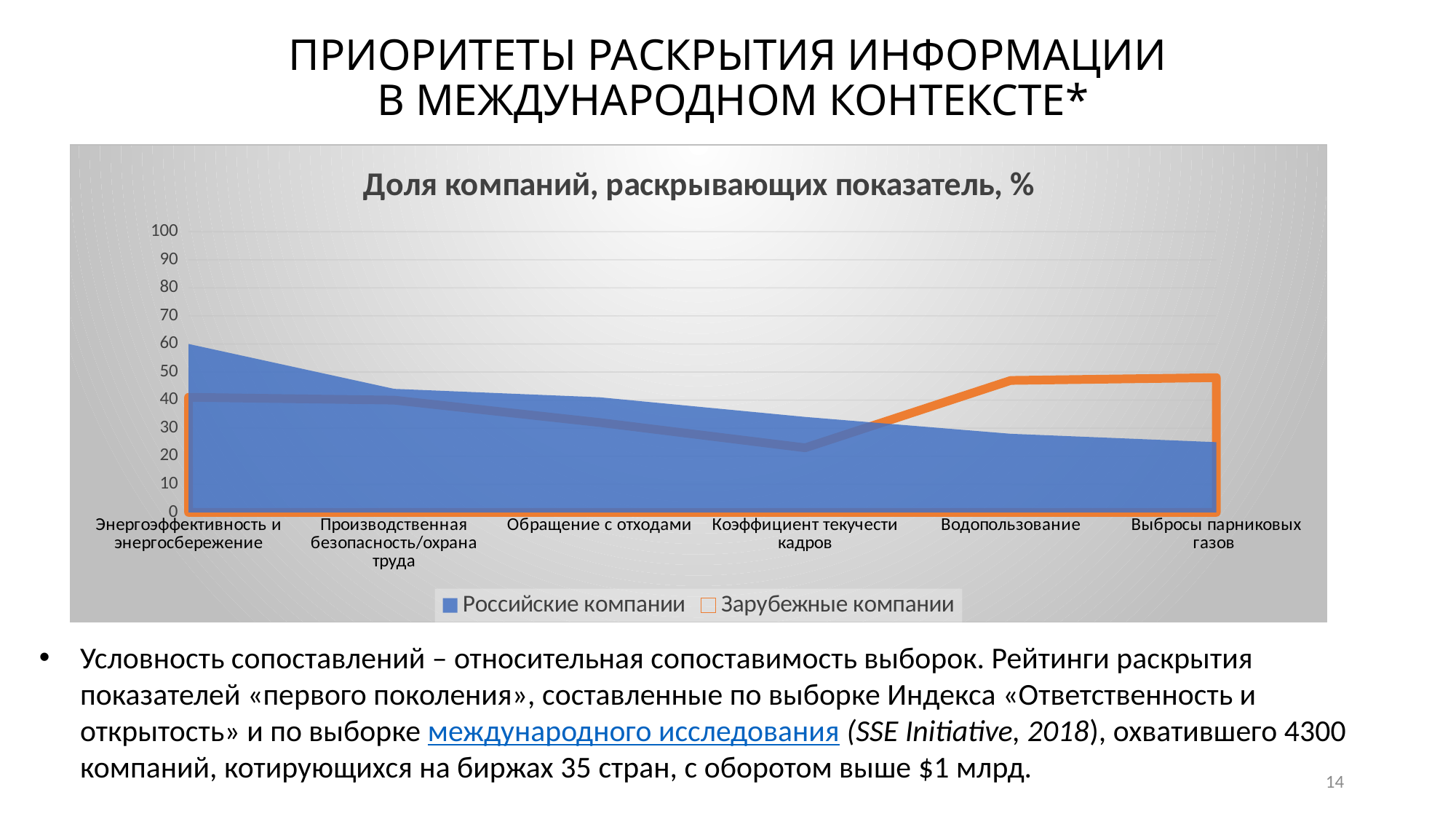
How many categories are shown on the x axis? 6 Is the value for Зарубежные компании at Водопользование greater or less than 40? greater At Выбросы парниковых газов, which series has the larger value: Российские компании or Зарубежные компании? Зарубежные компании What is the title of the chart? Доля компаний, раскрывающих показатель, % For which category is the value for Зарубежные компании lowest? Коэффициент текучести кадров For which category is the value for Российские компании highest? Энергоэффективность и энергосбережение What kind of chart is shown on the slide? Area chart For which category is the value for Российские компании lowest? Выбросы парниковых газов How many series does the legend list? 2 Is the value for Российские компании at Энергоэффективность и энергосбережение greater or less than 50? greater Which two series are listed in the legend? Российские компании and Зарубежные компании Do the values for Российские компании rise or fall from left to right along the x axis? Fall